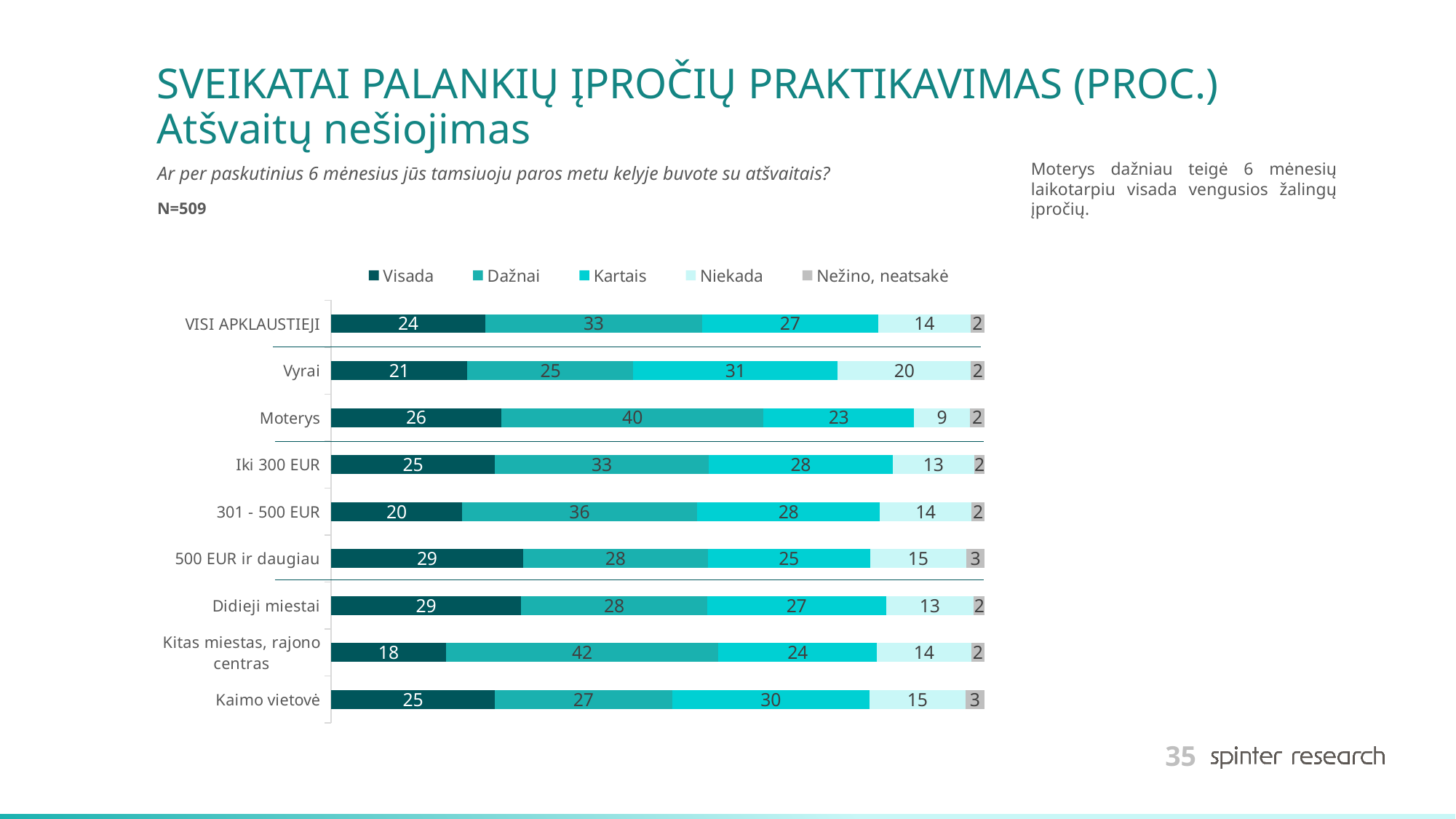
Which category has the lowest "Niekada" value? Moterys What is the total of the stacked bar for VISI APKLAUSTIEJI? 100 Which category has the highest "Dažnai" value? Kitas miestas, rajono centras What is the difference between the "Visada" values for Moterys and Vyrai? 5 What is the "Dažnai" value for Kitas miestas, rajono centras? 42 Which is larger: the "Kartais" value for Vyrai or for Moterys? Vyrai How many categories are shown on the chart? 9 What is the "Visada" value for Moterys? 26 What kind of chart is shown on the slide? Stacked bar chart What is the sample size (N) shown on the slide? N=509 What is the "Niekada" value for Vyrai? 20 How many series does the legend list? 5